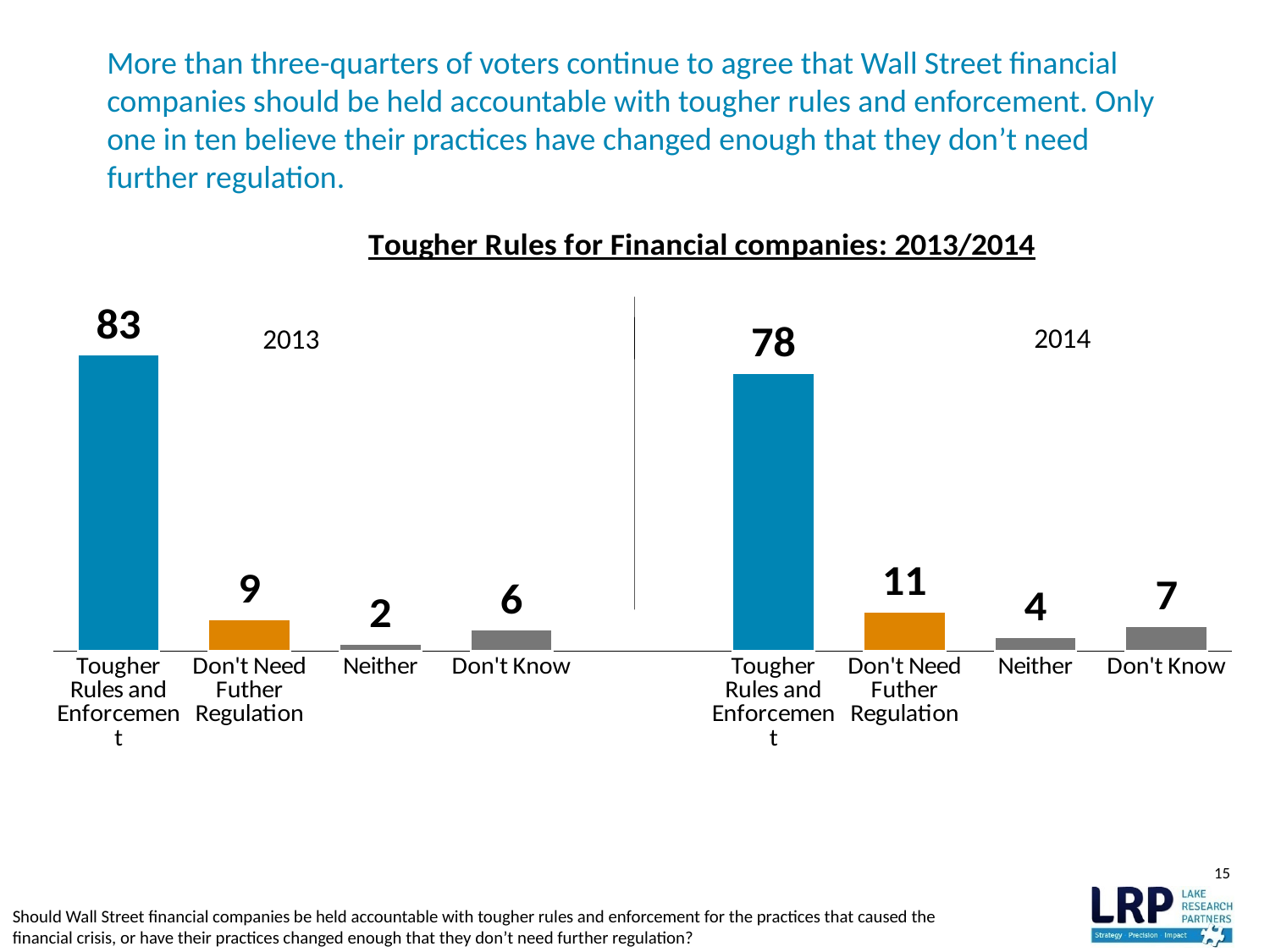
In the 2013 chart, what is the value for Neither? 2 What is the title of the chart on this slide? Tougher Rules for Financial companies: 2013/2014 What is the difference between the Tougher Rules and Enforcement values in the 2013 chart and the 2014 chart? 5 In the 2014 chart, what is the difference between Don't Need Futher Regulation and Neither? 7 In the 2013 chart, which category has the lowest value? Neither How many categories are shown in the 2013 chart? 4 In the 2014 chart, what is the value for Don't Know? 7 Which is larger: Don't Know in the 2013 chart or Don't Know in the 2014 chart? Don't Know in the 2014 chart What kind of chart is used on this slide? Bar chart In the 2014 chart, what is the value for Don't Need Futher Regulation? 11 In the 2014 chart, which category has the highest value? Tougher Rules and Enforcement In the 2013 chart, what is the value for Tougher Rules and Enforcement? 83